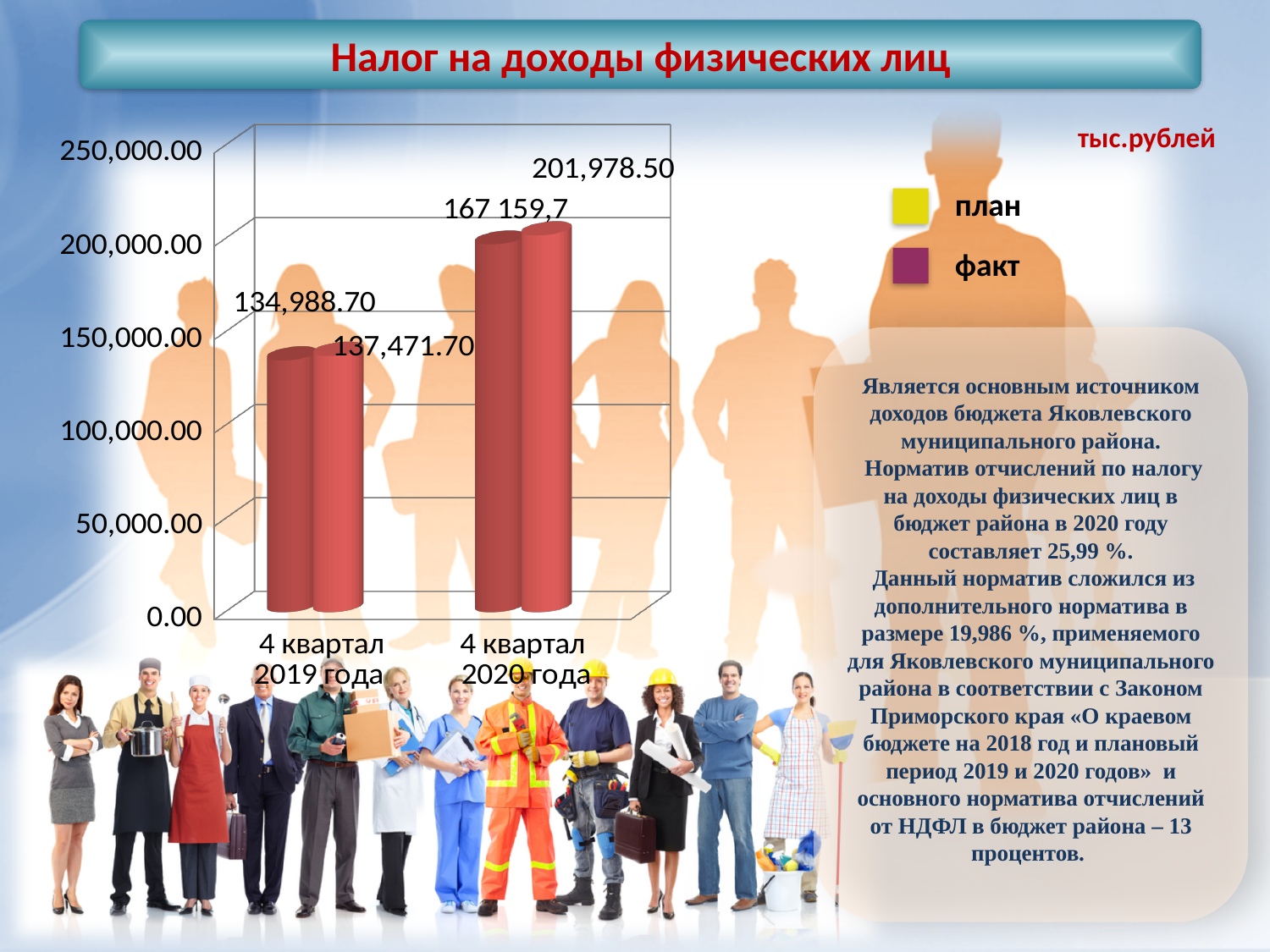
Which bar has the highest value in the chart? факт, 4 квартал 2020 года (201,978.50) What is the value of the right (факт) bar for 4 квартал 2020 года? 201,978.50 What is the value of the right (факт) bar for 4 квартал 2019 года? 137,471.70 What is the value of the left (план) bar for 4 квартал 2020 года? 167 159,7 Is the факт value for 4 квартал 2020 года greater or less than 200,000.00? greater What type of chart is shown on the slide? bar chart How many categories are shown on the x axis of the chart? 2 Do the values rise or fall from 4 квартал 2019 года to 4 квартал 2020 года? rise How many series does the chart legend list? 2 What is the title of the slide containing the chart? Налог на доходы физических лиц What is the value of the left (план) bar for 4 квартал 2019 года? 134,988.70